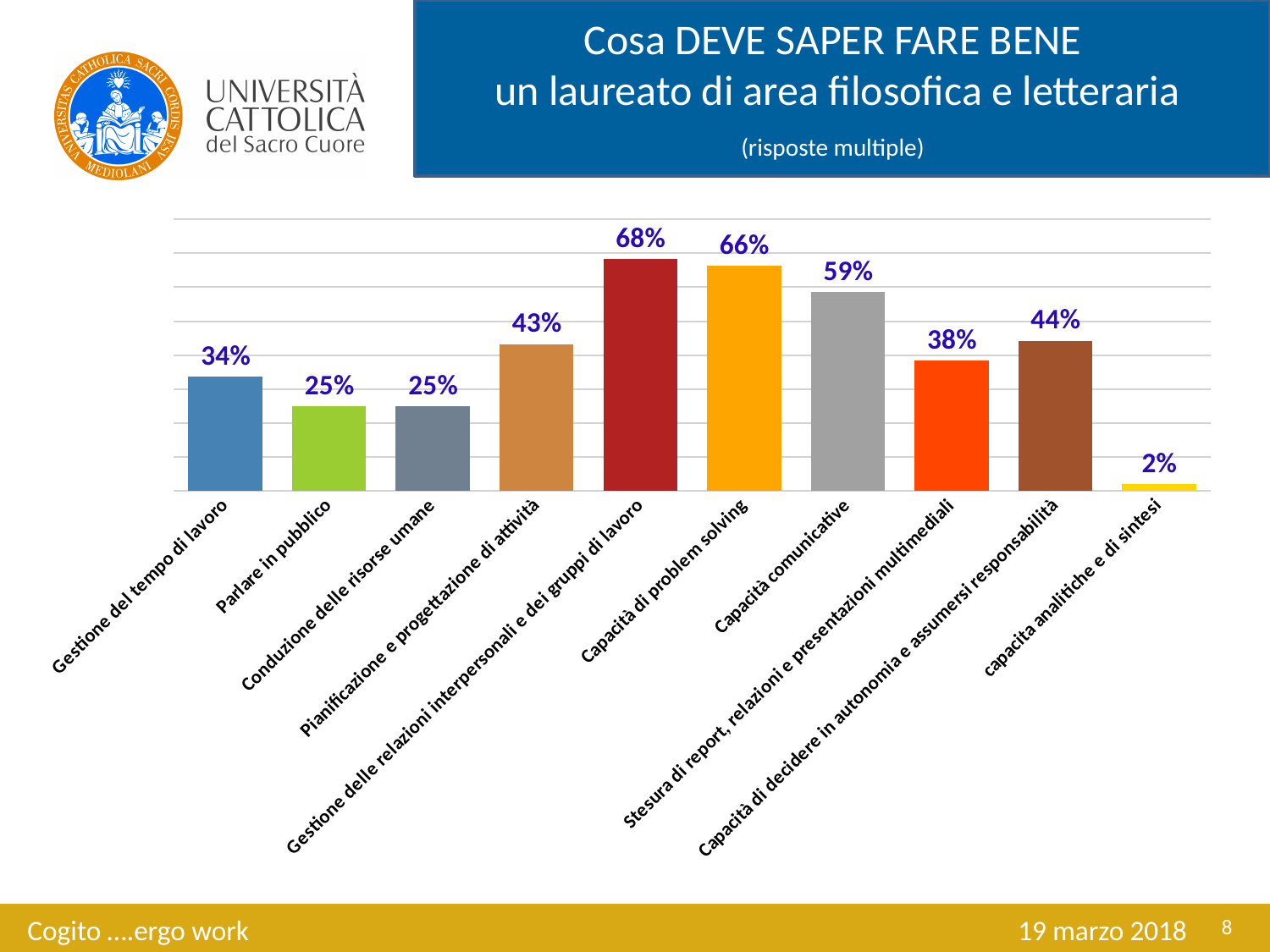
Which is larger: the value for "Capacità di decidere in autonomia e assumersi responsabilità" or the value for "Stesura di report, relazioni e presentazioni multimediali"? Capacità di decidere in autonomia e assumersi responsabilità What kind of chart is shown on the slide? Bar chart What is the difference between the values for "Capacità comunicative" and "Pianificazione e progettazione di attività"? 16% What is the difference between the values for "Gestione delle relazioni interpersonali e dei gruppi di lavoro" and "Capacità di problem solving"? 2% What is the value for "Gestione del tempo di lavoro"? 34% What is the value for "Capacità di problem solving"? 66% What is the value for "Parlare in pubblico"? 25% What is the subtitle shown in parentheses under the chart title? (risposte multiple) What is the value for "Stesura di report, relazioni e presentazioni multimediali"? 38% Which category has the lowest value? capacita analitiche e di sintesi How many categories are shown in the chart? 10 Which category has the highest value? Gestione delle relazioni interpersonali e dei gruppi di lavoro